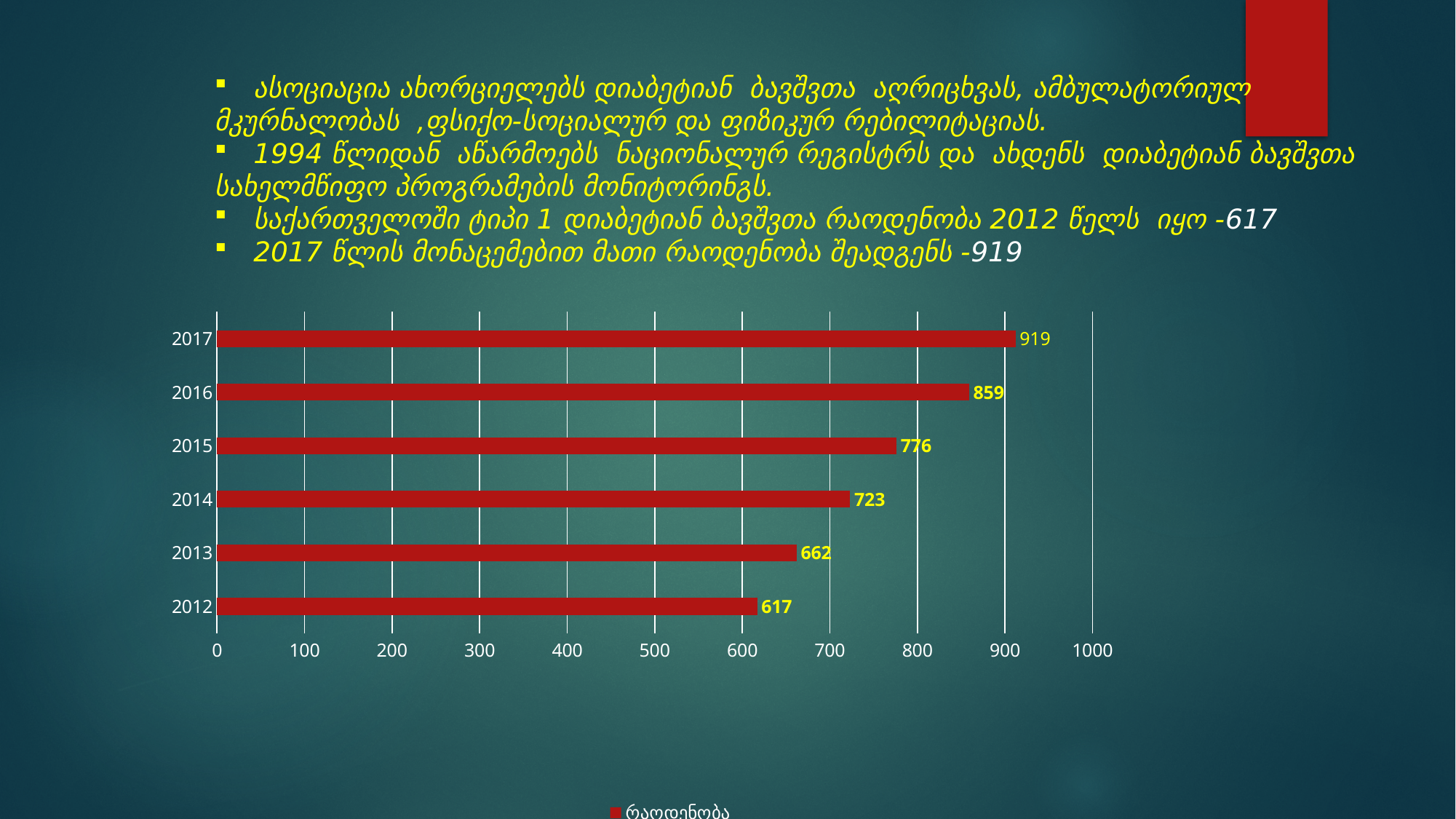
What is the value for 2014? 723 Is the value for 2016 greater or less than 800? greater What is the difference between the values for 2016 and 2015? 83 What is the difference between the values for 2017 and 2012? 302 Which year has the highest value? 2017 What is the value for 2012? 617 How many years are shown in the chart? 6 What kind of chart is shown on the slide? bar chart Which year has the lowest value? 2012 What is the legend entry shown below the chart? რაოდენობა Which is larger, the value for 2013 or the value for 2015? 2015 What is the value for 2017? 919